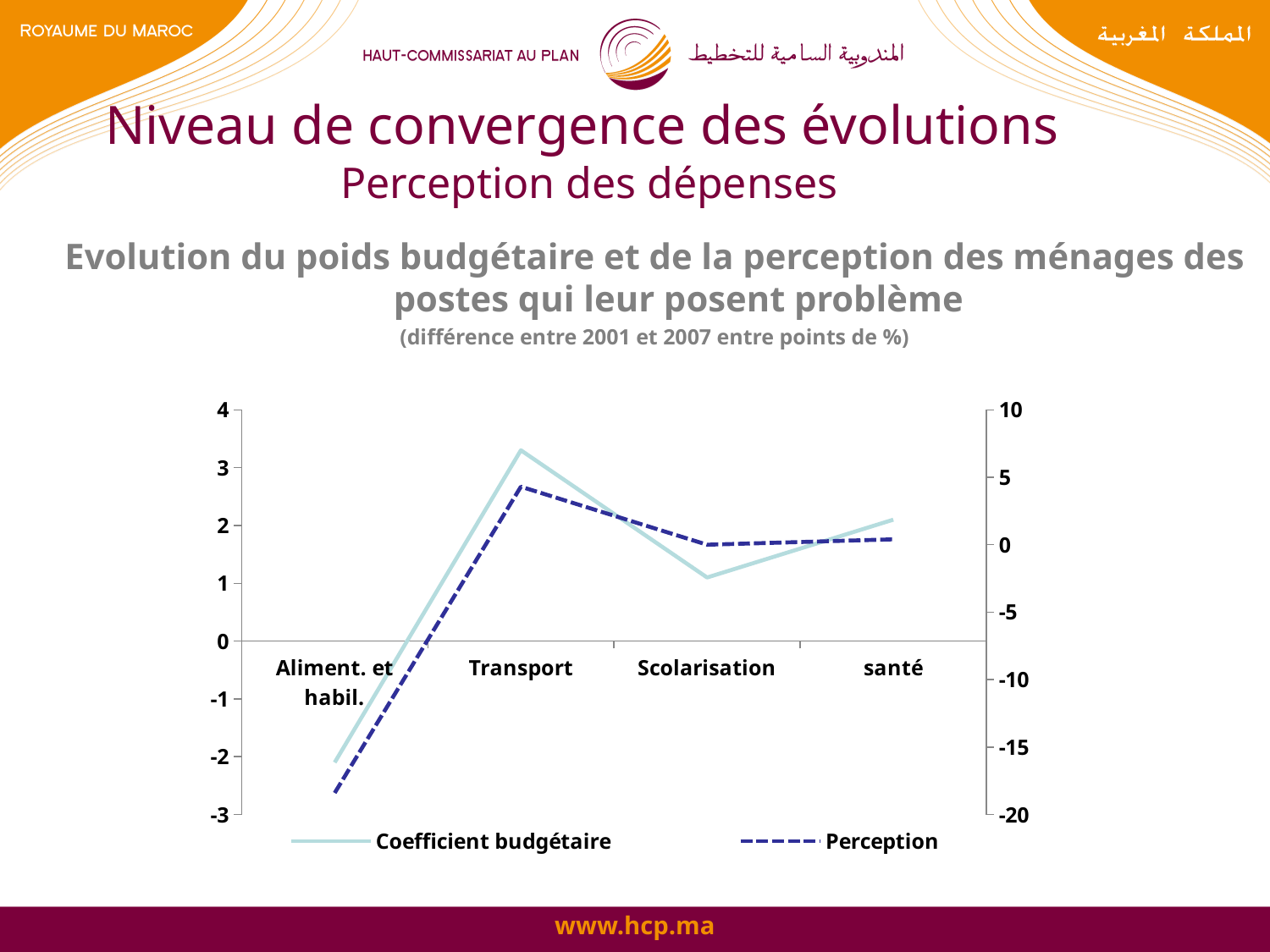
Which category has the highest value for the Coefficient budgétaire series? Transport Is the Coefficient budgétaire value for Scolarisation greater or less than 2? less What kind of chart is shown on the slide? Line chart How many categories are plotted along the x axis? 4 Is the Perception value for Aliment. et habil. greater or less than -10 on the right axis? less Which category has the lowest value for the Perception series? Aliment. et habil. Is the Coefficient budgétaire value for Aliment. et habil. greater or less than -1? less Does the Coefficient budgétaire line rise or fall from Transport to Scolarisation? fall For the Coefficient budgétaire series, which is larger: Scolarisation or santé? santé How many series does the legend list? 2 Which series is drawn with a dashed line? Perception